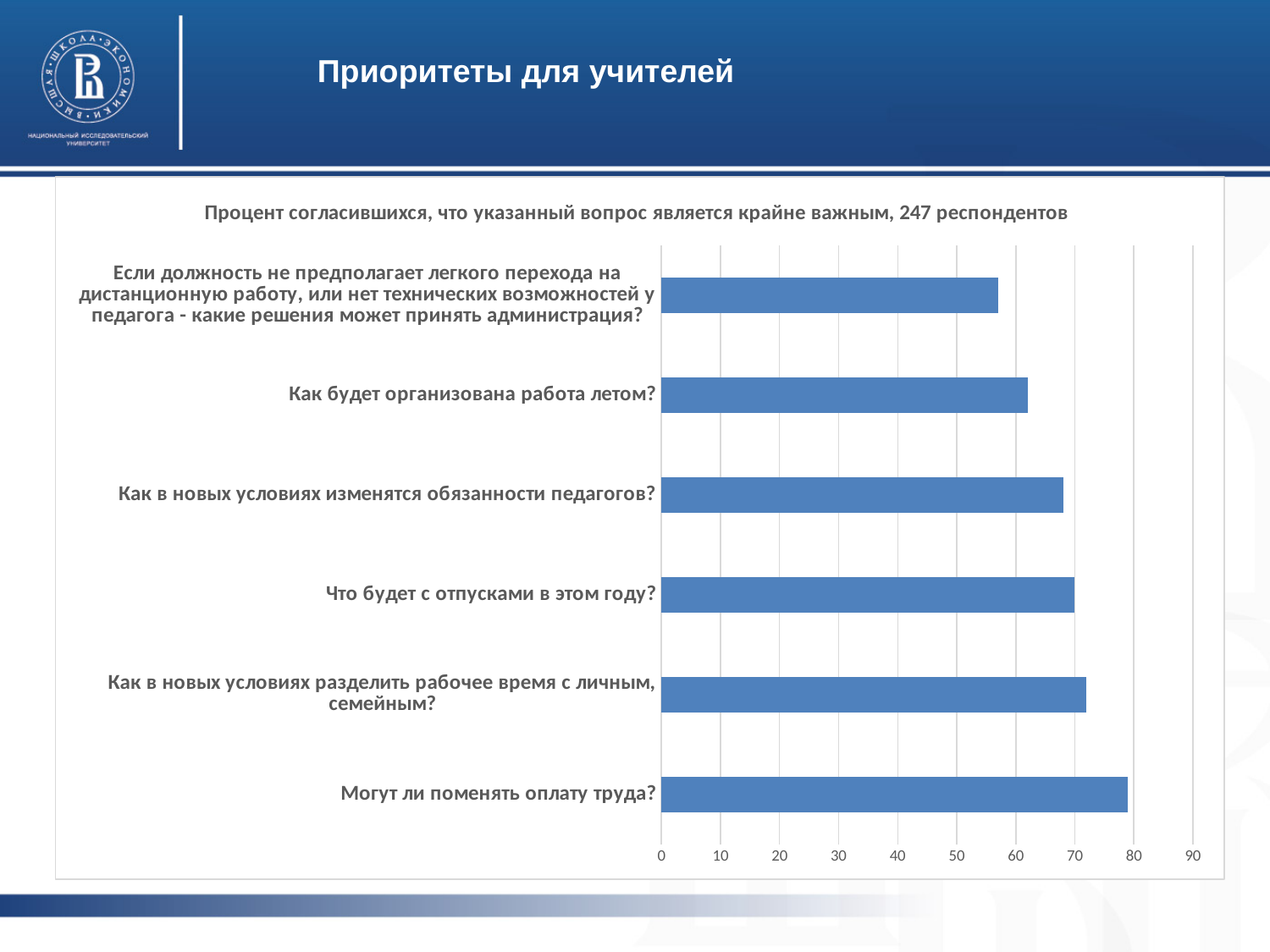
What kind of chart is shown on the slide? bar chart Which has a larger value: "Как в новых условиях изменятся обязанности педагогов?" or "Если должность не предполагает легкого перехода на дистанционную работу..." Как в новых условиях изменятся обязанности педагогов? Is the value for "Что будет с отпусками в этом году?" greater or less than 60? greater Which category has the highest value in the chart? Могут ли поменять оплату труда? Which has a larger value: "Могут ли поменять оплату труда?" or "Как будет организована работа летом?" Могут ли поменять оплату труда? Which category has the lowest value in the chart? Если должность не предполагает легкого перехода на дистанционную работу, или нет технических возможностей у педагога - какие решения может принять администрация? Is the value for "Как будет организована работа летом?" greater or less than 70? less Is the value for "Могут ли поменять оплату труда?" greater or less than 70? greater How many respondents does the chart title say took part? 247 How many categories (questions) are plotted in the chart? 6